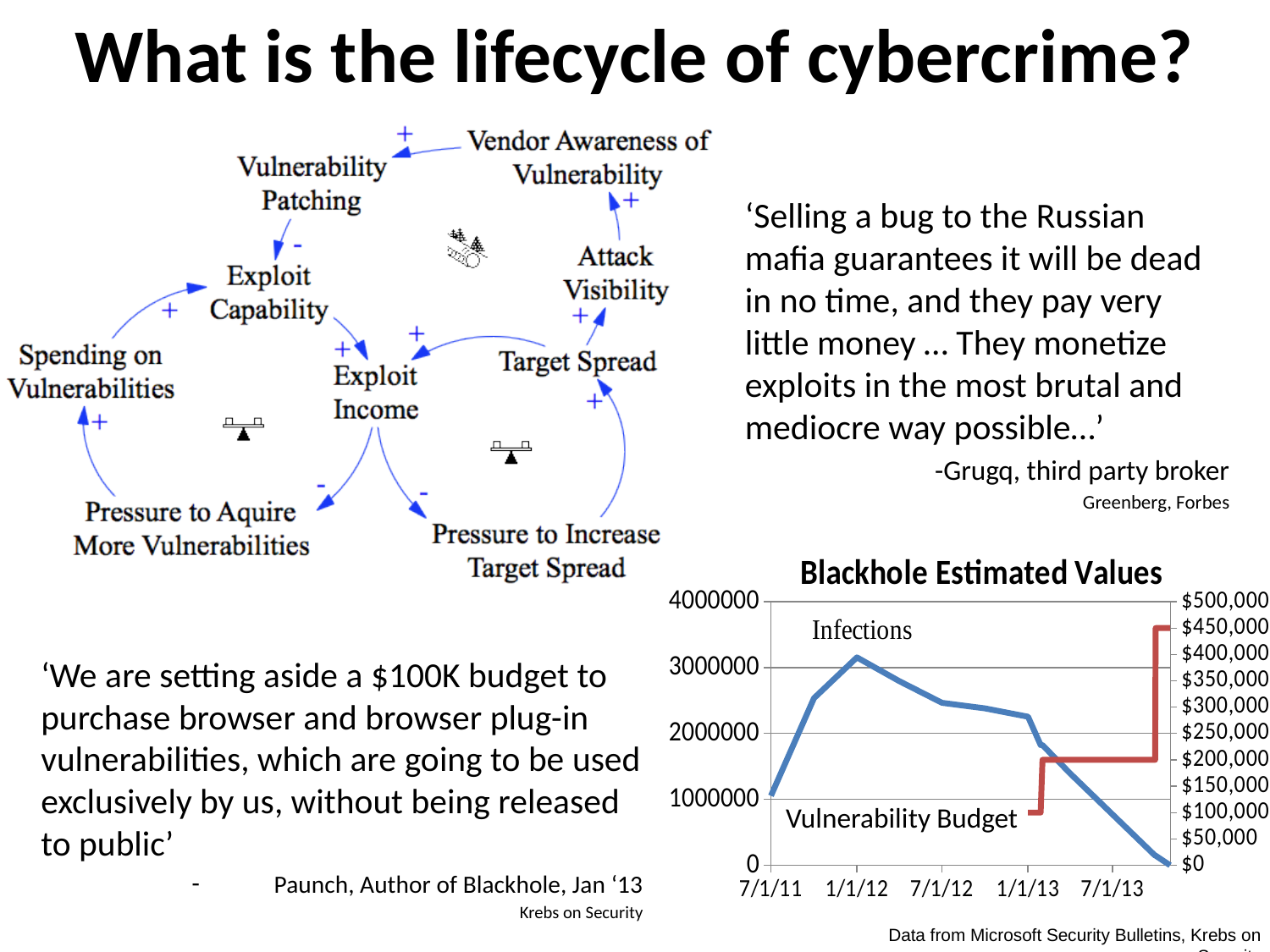
In the "Blackhole Estimated Values" chart, is the Infections value at 7/1/12 greater or less than 2000000? greater In the "Blackhole Estimated Values" chart, does the Infections series rise or fall after 1/1/12? fall In the "Blackhole Estimated Values" chart, is the final Vulnerability Budget value greater or less than $400,000? greater What is the maximum value shown on the right-hand axis of the "Blackhole Estimated Values" chart? $500,000 In the "Blackhole Estimated Values" chart, does the Vulnerability Budget series rise or fall over time? rise In the "Blackhole Estimated Values" chart, is the Infections value at 7/1/11 greater or less than 2000000? less What are the names of the two series in the "Blackhole Estimated Values" chart? Infections and Vulnerability Budget In the "Blackhole Estimated Values" chart, around which x-axis date does the Infections series reach its highest point? 1/1/12 How many data series are plotted in the "Blackhole Estimated Values" chart? 2 What kind of chart is "Blackhole Estimated Values"? line chart